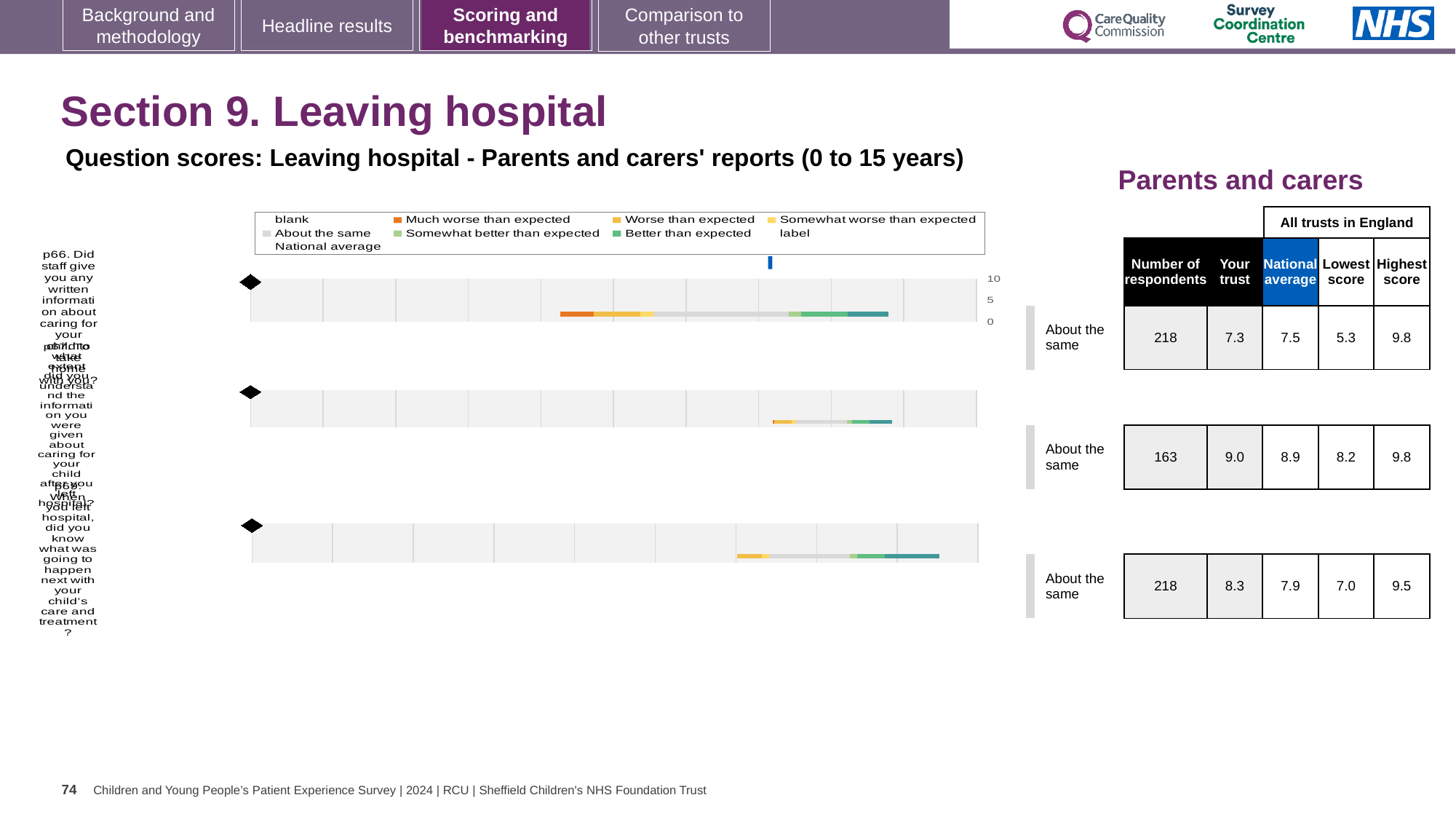
In the chart legend, which colour represents 'Much worse than expected'? orange How many separate bar charts are shown on the slide? 3 What is the highest tick value shown on the chart axis? 10 What kind of chart is used to show the question scores on this slide? bar chart In the chart legend, what label is shown for the dark blue marker? National average